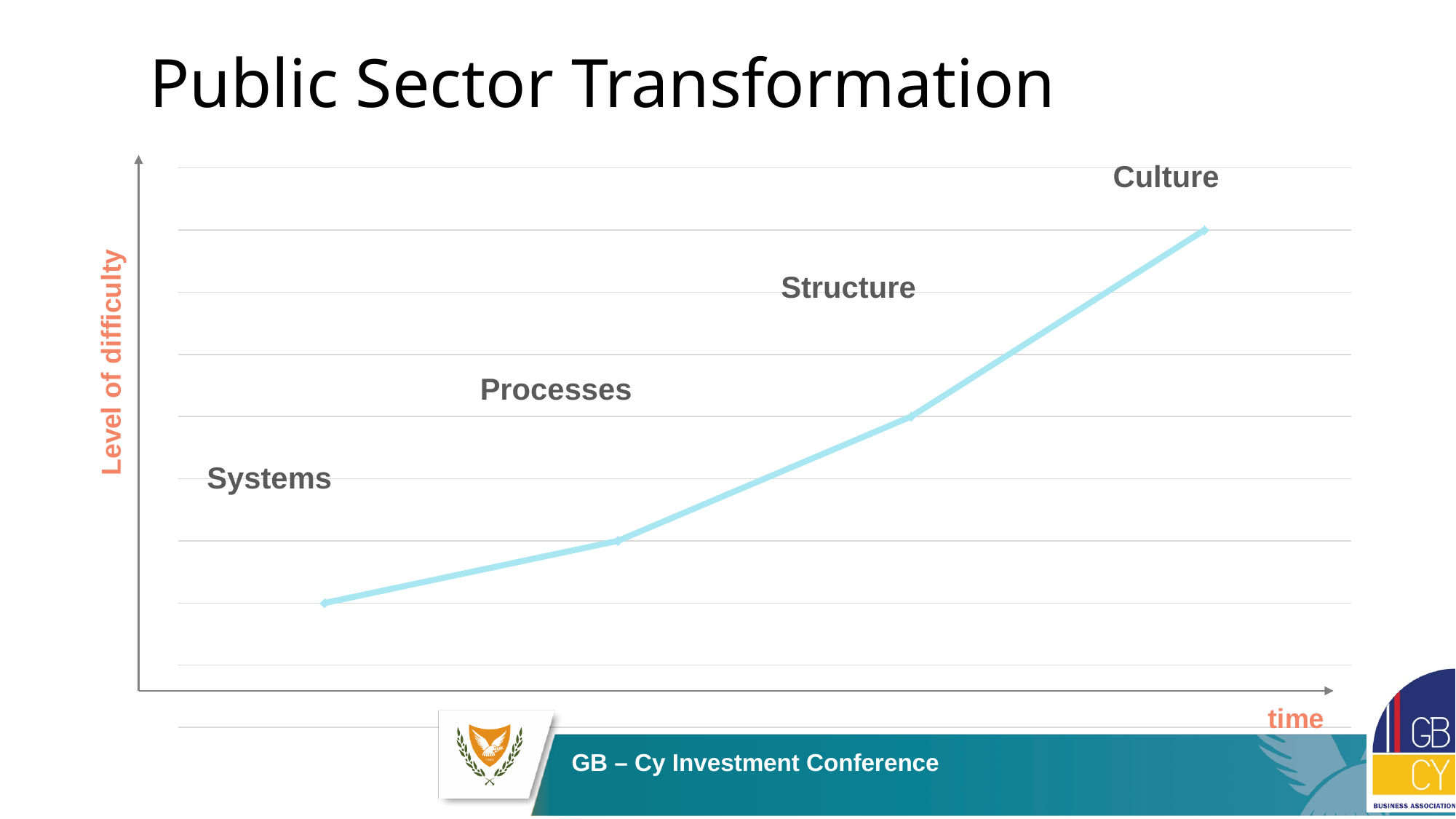
What is the label of the horizontal axis? time Which labelled point has the lowest level of difficulty? Systems Which has a higher level of difficulty, Processes or Systems? Processes Which has a lower level of difficulty, Systems or Culture? Systems How many labelled points are plotted on the line? 4 Do the values rise or fall along the x axis from Systems to Culture? rise Which labelled point comes last along the time axis? Culture Which labelled point has the highest level of difficulty? Culture Which labelled point comes first along the time axis? Systems Which has a higher level of difficulty, Structure or Processes? Structure What kind of chart is shown on the slide? line chart What is the label of the vertical axis? Level of difficulty